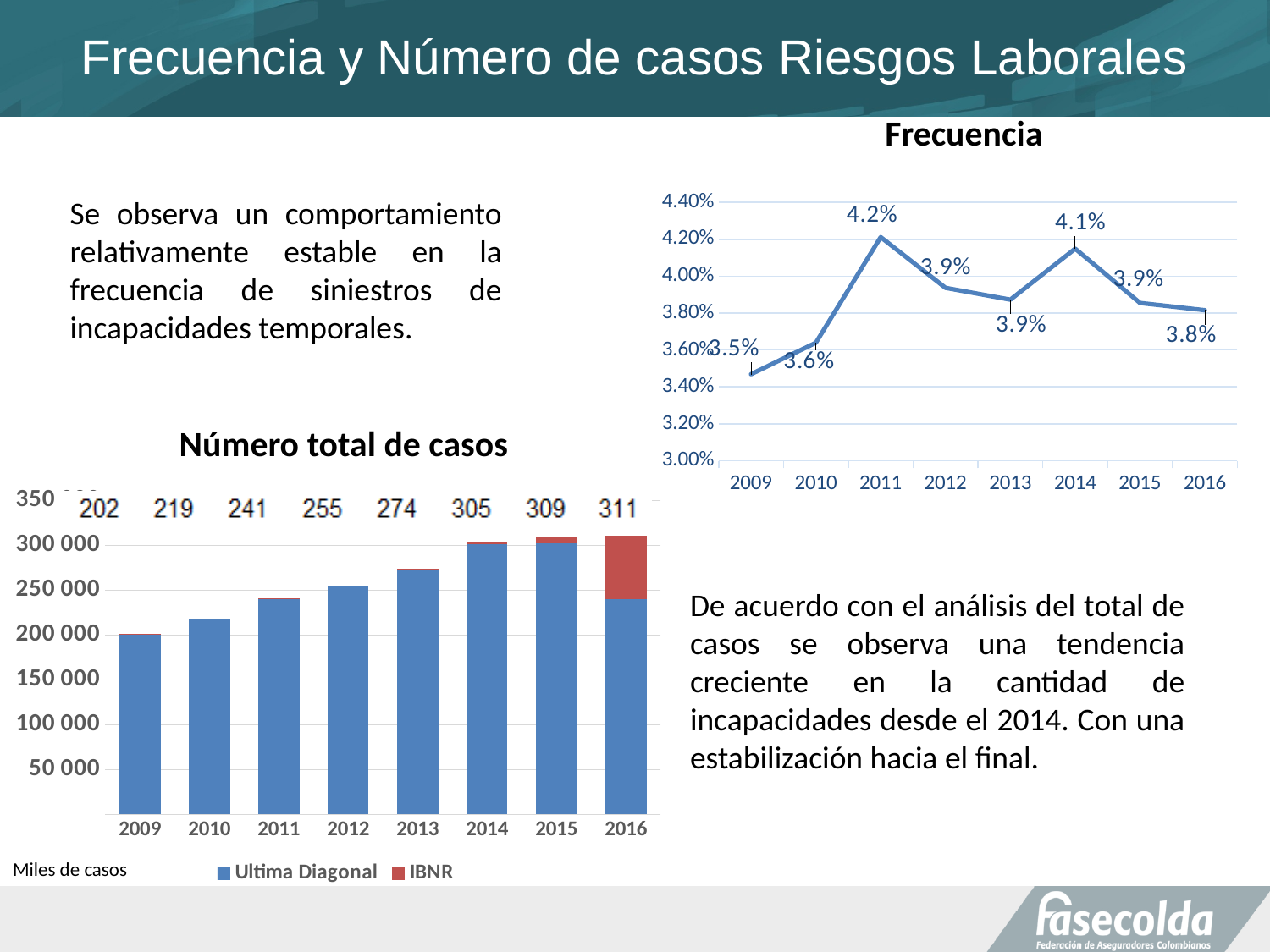
In the Frecuencia chart, which year has the lowest frequency? 2009 In the Número total de casos chart, what is the difference between the 2016 total and the 2009 total? 109 In the Número total de casos chart, is the Ultima Diagonal value for 2016 greater or less than 300 000? less What kind of chart is the Número total de casos chart? Stacked bar chart In the Número total de casos chart, how many series does the legend list? 2 In the Frecuencia chart, which is larger, the value for 2011 or the value for 2014? 2011 In the Número total de casos chart, what is the total labelled for 2013? 274 In the Número total de casos chart, which year has the highest total? 2016 In the Frecuencia chart, what is the difference between the 2011 value and the 2009 value? 0.7 percentage points In the Frecuencia chart, what is the value for 2011? 4.2% In the Frecuencia chart, how many years are plotted on the x axis? 8 In the Frecuencia chart, which year has the highest frequency? 2011